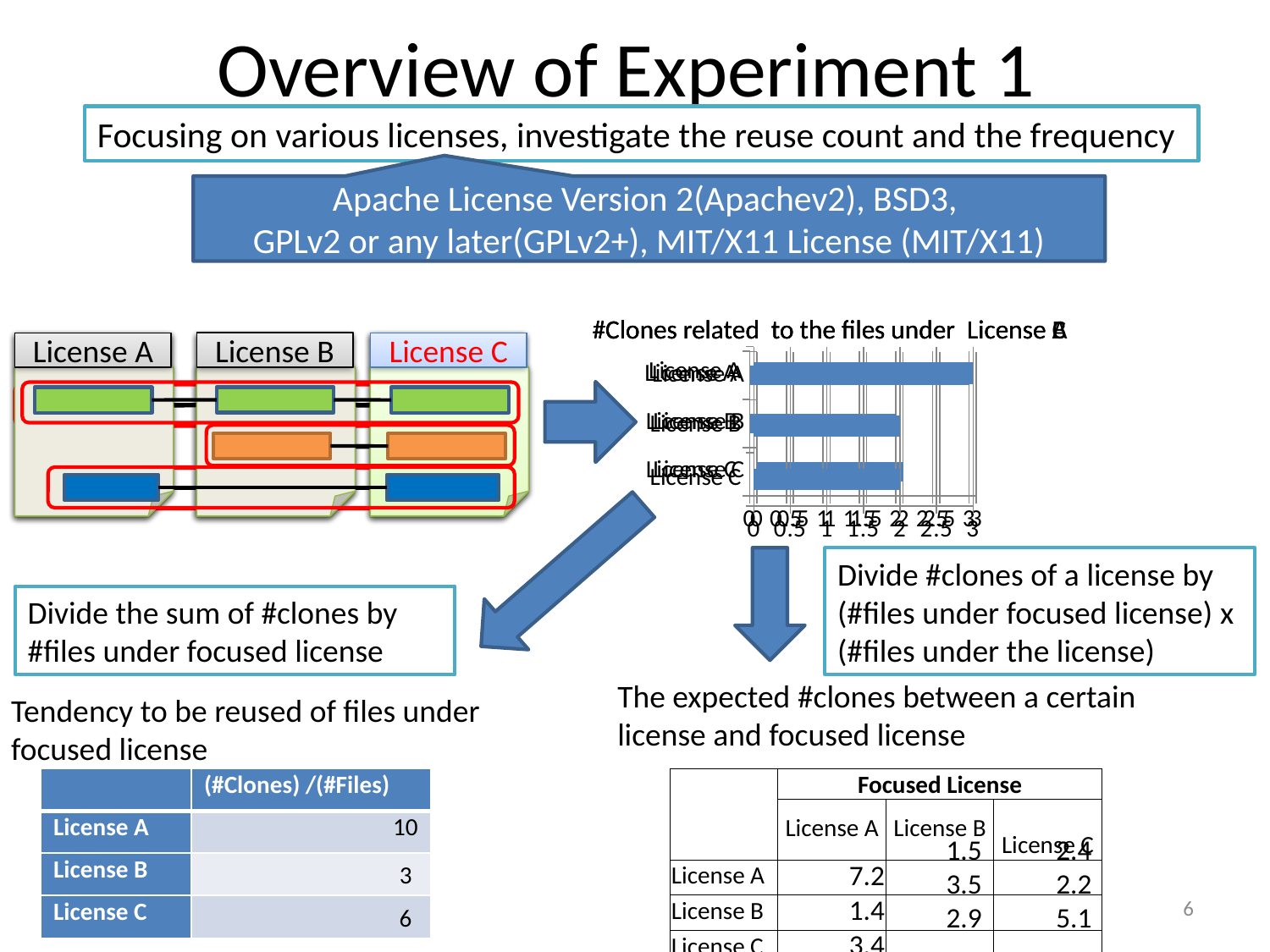
Which category has the longest bar in the chart? License A Is the value for License C in the bar chart greater or less than 2.5? less Which has the larger value in the bar chart, License A or License B? License A What is the highest tick value shown on the horizontal axis of the bar chart? 3 What is the label of the top category in the bar chart? License A Is the value for License B in the bar chart greater or less than 1? greater How many categories does the bar chart show? 3 What kind of chart is shown on the slide? bar chart Is the value for License B in the bar chart greater or less than 2.5? less Which has the larger value in the bar chart, License A or License C? License A